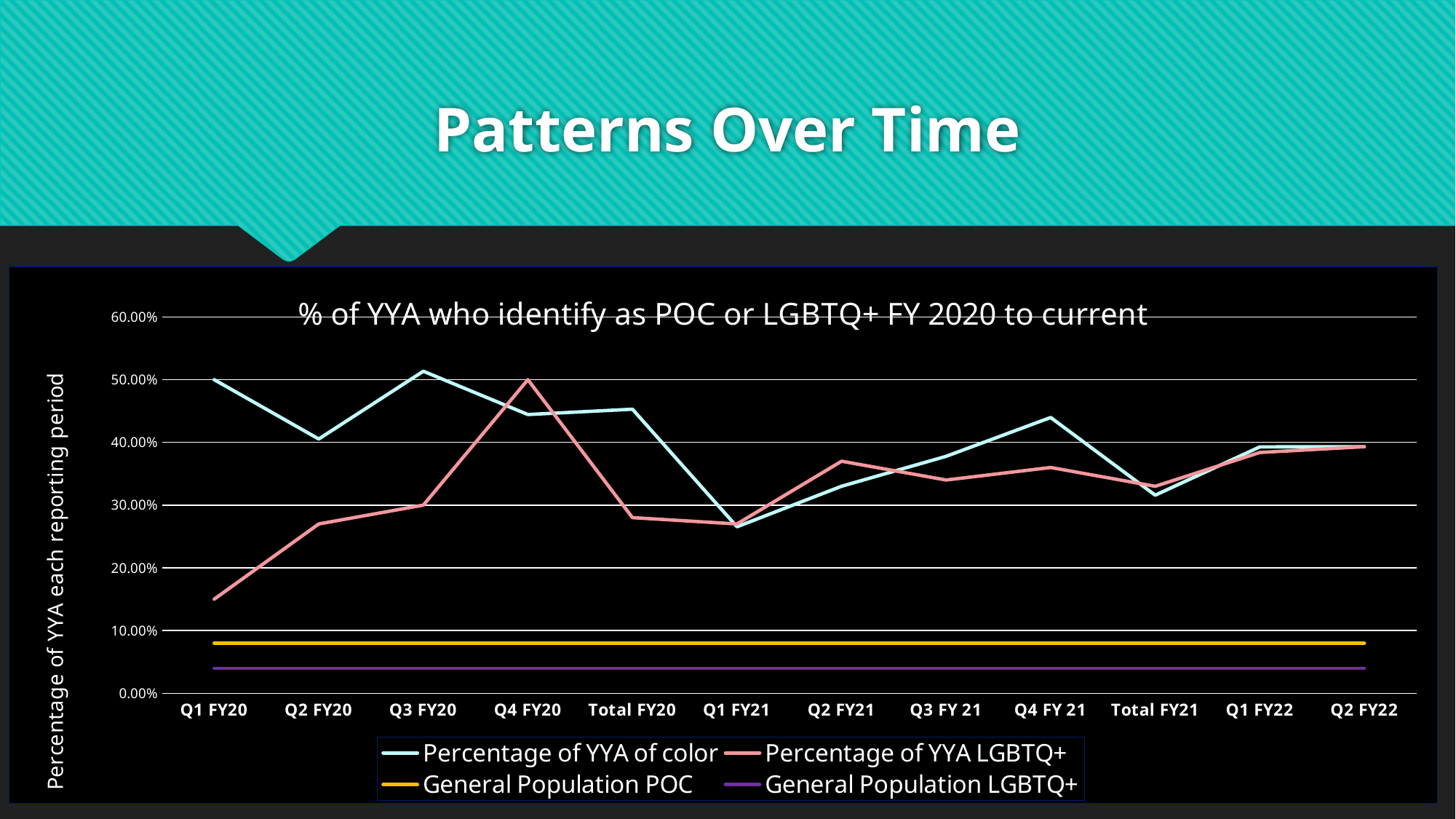
In which reporting period is Percentage of YYA LGBTQ+ lowest? Q1 FY20 Is the value for Percentage of YYA of color at Q1 FY21 greater or less than 30.00%? less Does Percentage of YYA LGBTQ+ rise or fall from Q1 FY20 to Q4 FY20? rise At Q4 FY20, which is larger: Percentage of YYA of color or Percentage of YYA LGBTQ+? Percentage of YYA LGBTQ+ Is the General Population POC line greater or less than 10.00%? less How many reporting periods are shown along the x axis? 12 Is the value for Percentage of YYA of color at Q1 FY20 greater or less than 40.00%? greater What kind of chart is shown on the slide? line chart How many series does the legend list? 4 At Q1 FY20, which is larger: Percentage of YYA of color or Percentage of YYA LGBTQ+? Percentage of YYA of color In which reporting period is Percentage of YYA LGBTQ+ highest? Q4 FY20